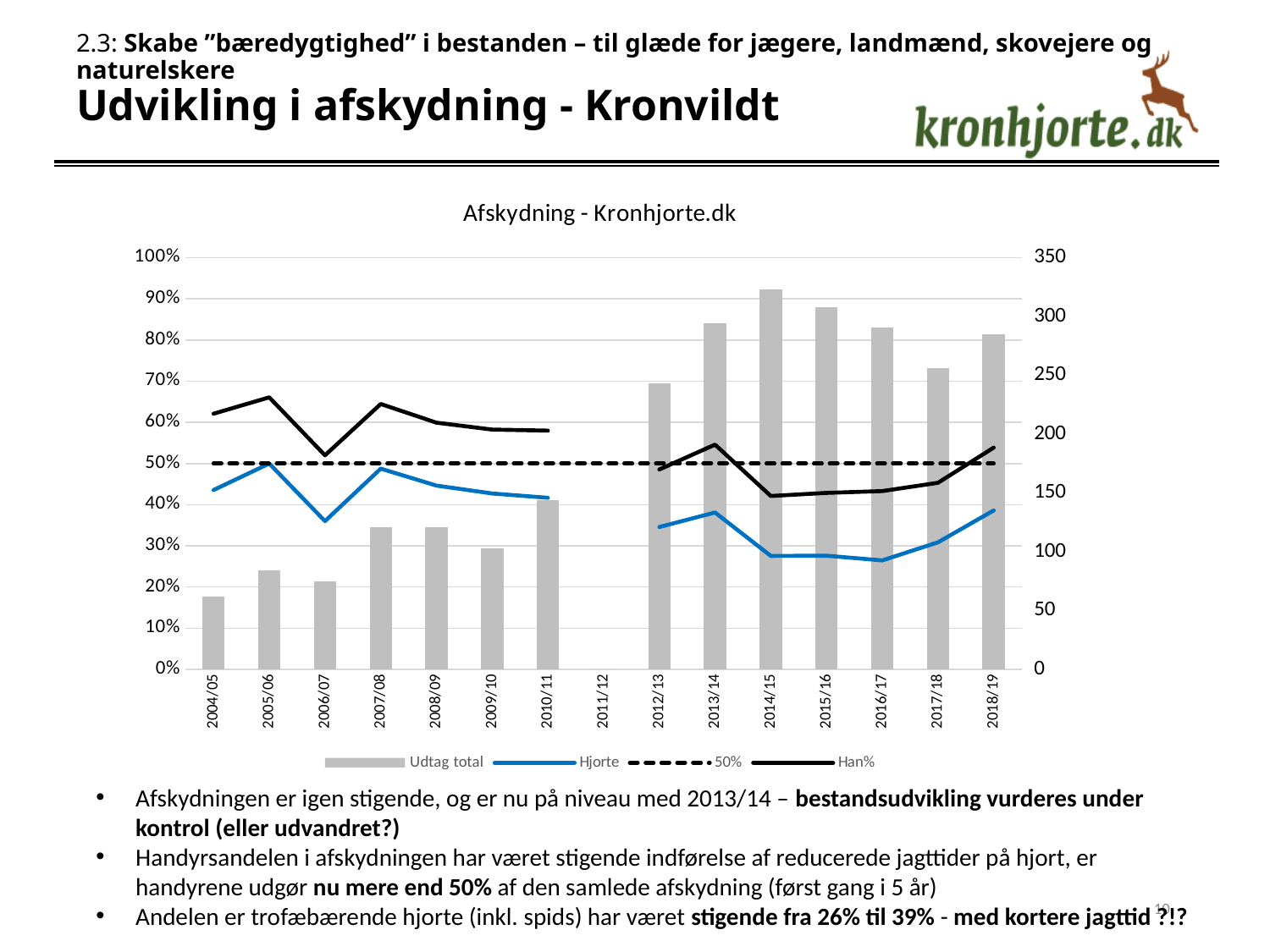
Is the Udtag total for 2014/15 greater or less than 300? greater What is the title of the chart? Afskydning - Kronhjorte.dk How many series does the chart legend list? 4 Which season has the lowest Udtag total bar? 2004/05 Does the Udtag total rise or fall from 2012/13 to 2014/15? rise Is the Udtag total for 2004/05 greater or less than 100? less Is the Hjorte value for 2016/17 greater or less than 30%? less Which season has the highest Udtag total bar? 2014/15 What kind of chart is shown on the slide? Combined bar and line chart How many seasons are shown on the x axis of the chart? 15 Which is larger, the Udtag total for 2013/14 or for 2017/18? 2013/14